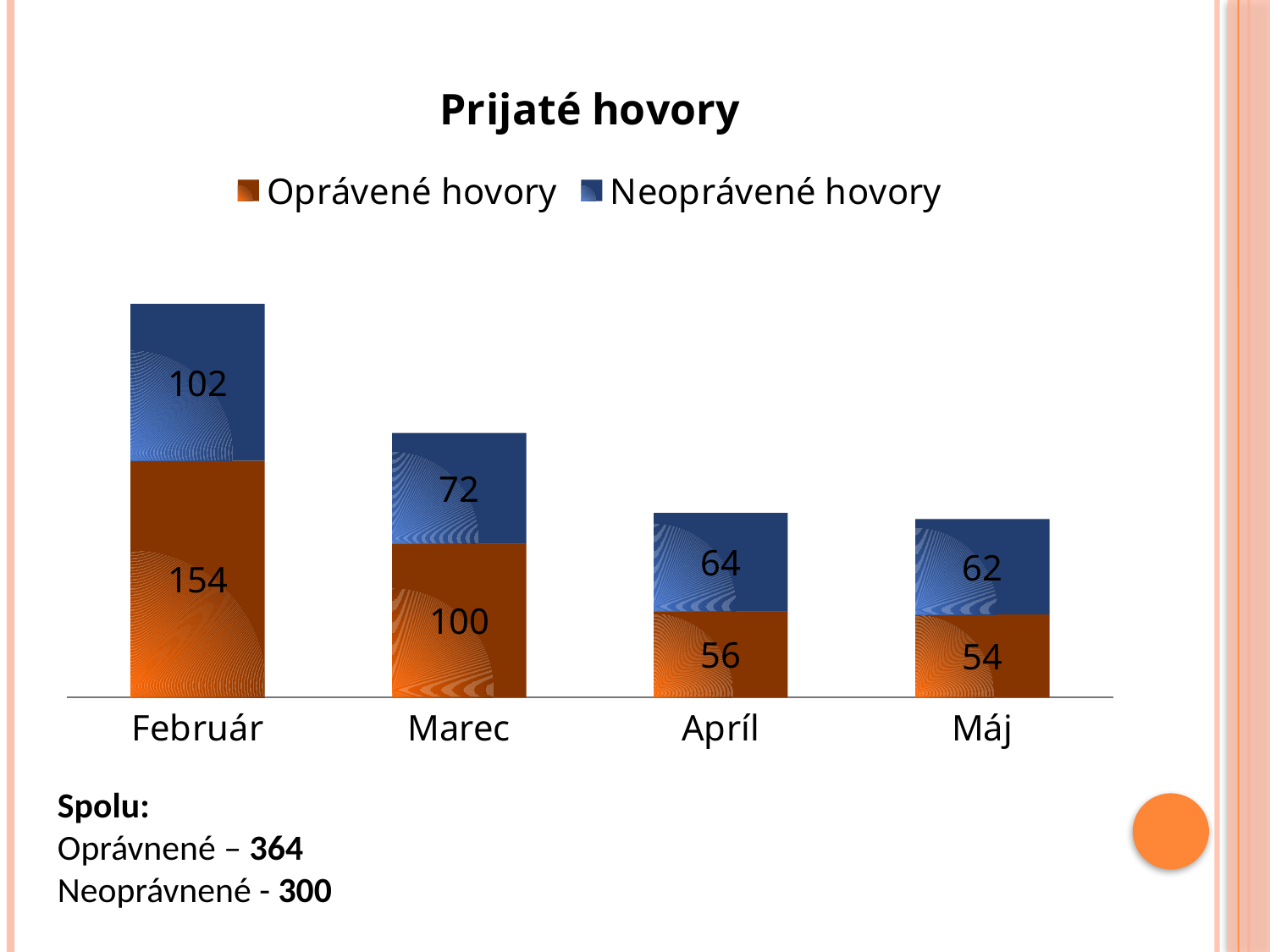
What is the total of the stacked bar for Február? 256 How many series does the legend list? 2 What is the value of Oprávené hovory for Február? 154 Which is larger: Oprávené hovory in Apríl or Neoprávené hovory in Apríl? Neoprávené hovory in Apríl Which month has the highest value for Oprávené hovory? Február What is the difference between Oprávené hovory in Február and Marec? 54 Which month has the lowest value for Neoprávené hovory? Máj How many months are shown on the x axis? 4 What is the value of Neoprávené hovory for Apríl? 64 What is the value of Neoprávené hovory for Marec? 72 What is the total of the stacked bar for Máj? 116 What type of chart is shown? Stacked bar chart